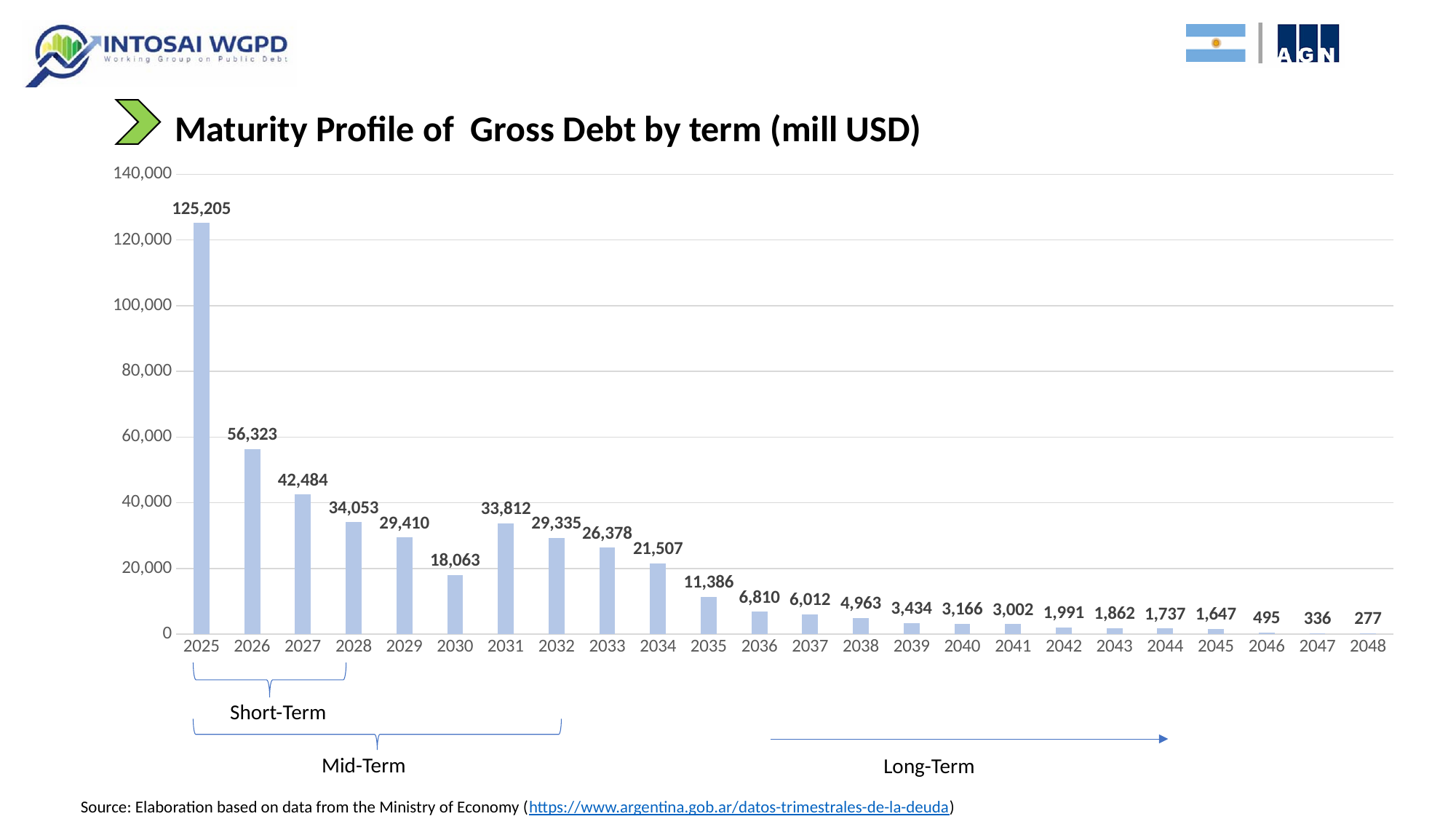
What is the difference between the values for 2025 and 2026? 68,882 What is the title of the chart? Maturity Profile of Gross Debt by term (mill USD) What kind of chart is shown on the slide? bar chart How many years are shown on the x axis? 24 Which year has the highest value? 2025 Which year has the lowest value? 2048 What is the value for 2030? 18,063 Which is larger, the value for 2031 or the value for 2030? 2031 What is the difference between the values for 2031 and 2030? 15,749 What is the value for 2025? 125,205 What is the value for 2048? 277 Is the value for 2026 greater or less than 60,000? less